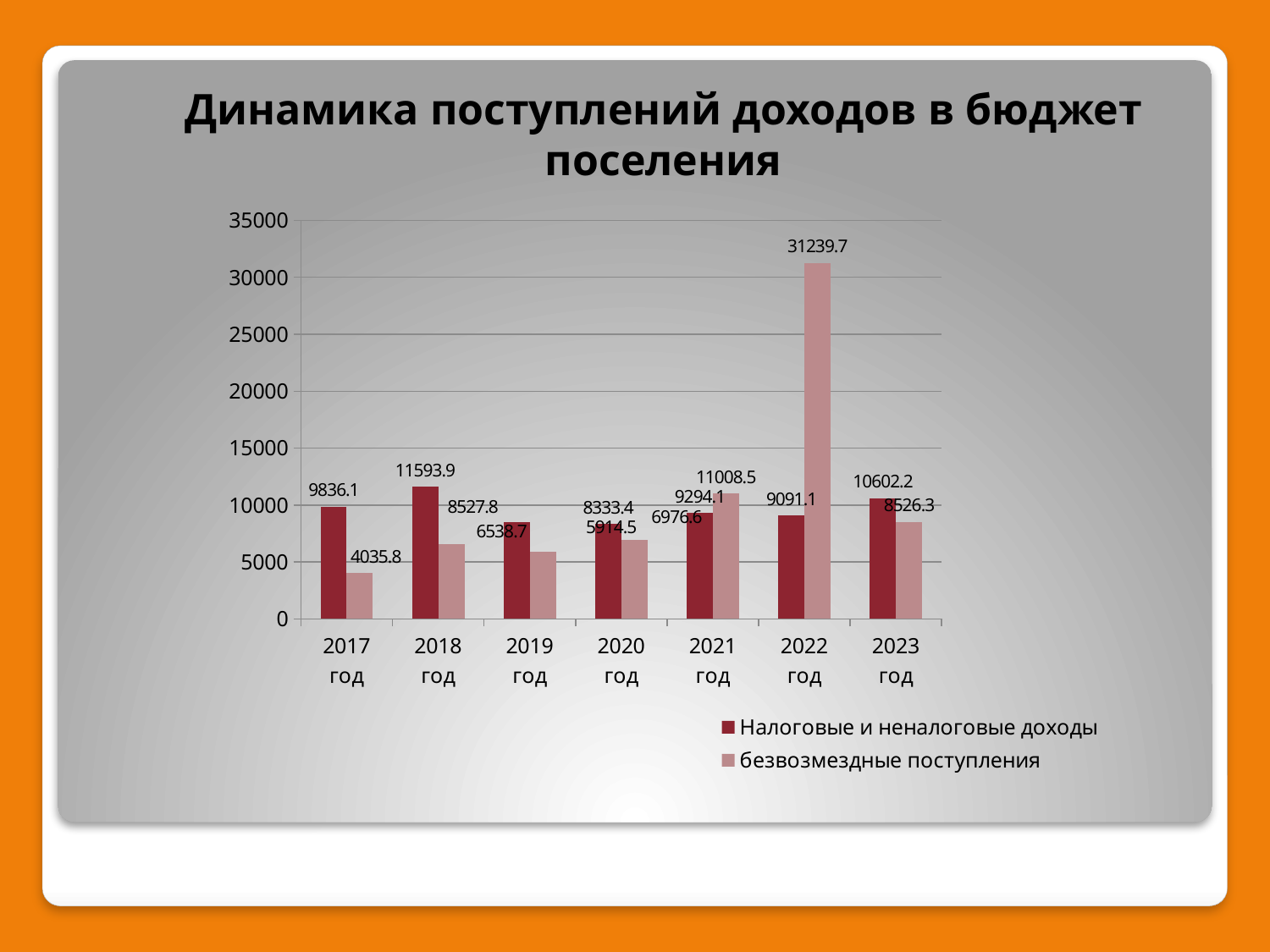
In which year is Налоговые и неналоговые доходы the highest? 2018 год What is the difference between Налоговые и неналоговые доходы and безвозмездные поступления in 2017 год? 5800.3 What is the value of Налоговые и неналоговые доходы for 2017 год? 9836.1 In which year is безвозмездные поступления the lowest? 2017 год What is the value of Налоговые и неналоговые доходы for 2023 год? 10602.2 What is the value of безвозмездные поступления for 2022 год? 31239.7 In which year is безвозмездные поступления the highest? 2022 год How many years are shown on the x axis? 7 What kind of chart is shown on the slide? bar chart How many series does the legend list? 2 In 2022 год, which series has the larger value: Налоговые и неналоговые доходы or безвозмездные поступления? безвозмездные поступления What is the value of безвозмездные поступления for 2017 год? 4035.8